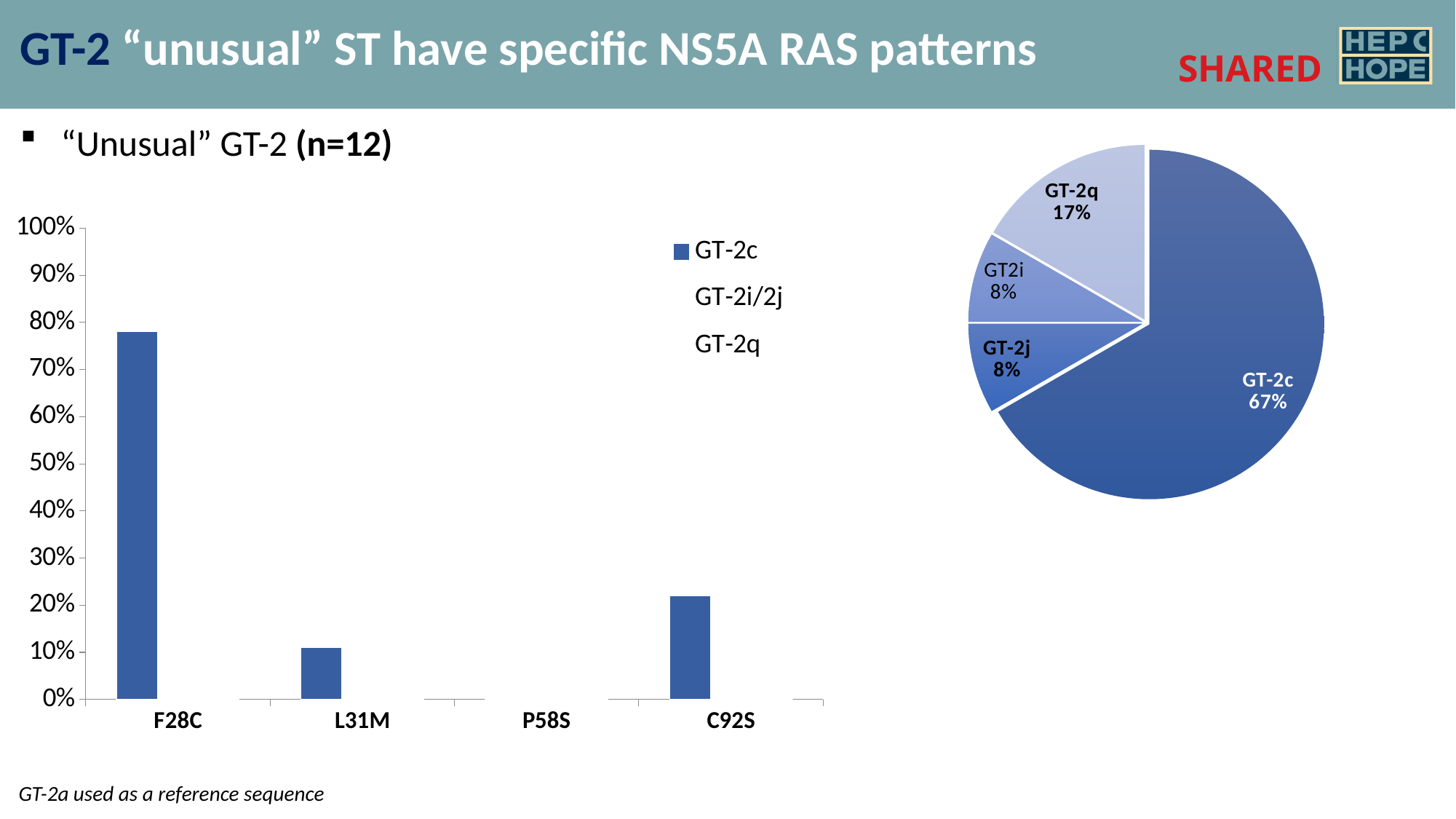
In the pie chart on the right, what share does GT-2j have? 8% In the bar chart on the left, which category has the tallest bar? F28C In the pie chart on the right, which slice is the largest? GT-2c What kind of chart is the chart on the left of the slide? Bar chart In the pie chart on the right, what is the difference between the GT-2c share and the GT-2q share? 50% In the pie chart on the right, how many slices are there? 4 In the pie chart on the right, what share does GT-2q have? 17% In the pie chart on the right, which is larger, the GT-2q slice or the GT2i slice? GT-2q In the bar chart on the left, is the value for F28C greater or less than 70%? greater In the bar chart on the left, how many series does the legend list? 3 In the bar chart on the left, how many categories are shown on the x axis? 4 In the pie chart on the right, what share does GT-2c have? 67%